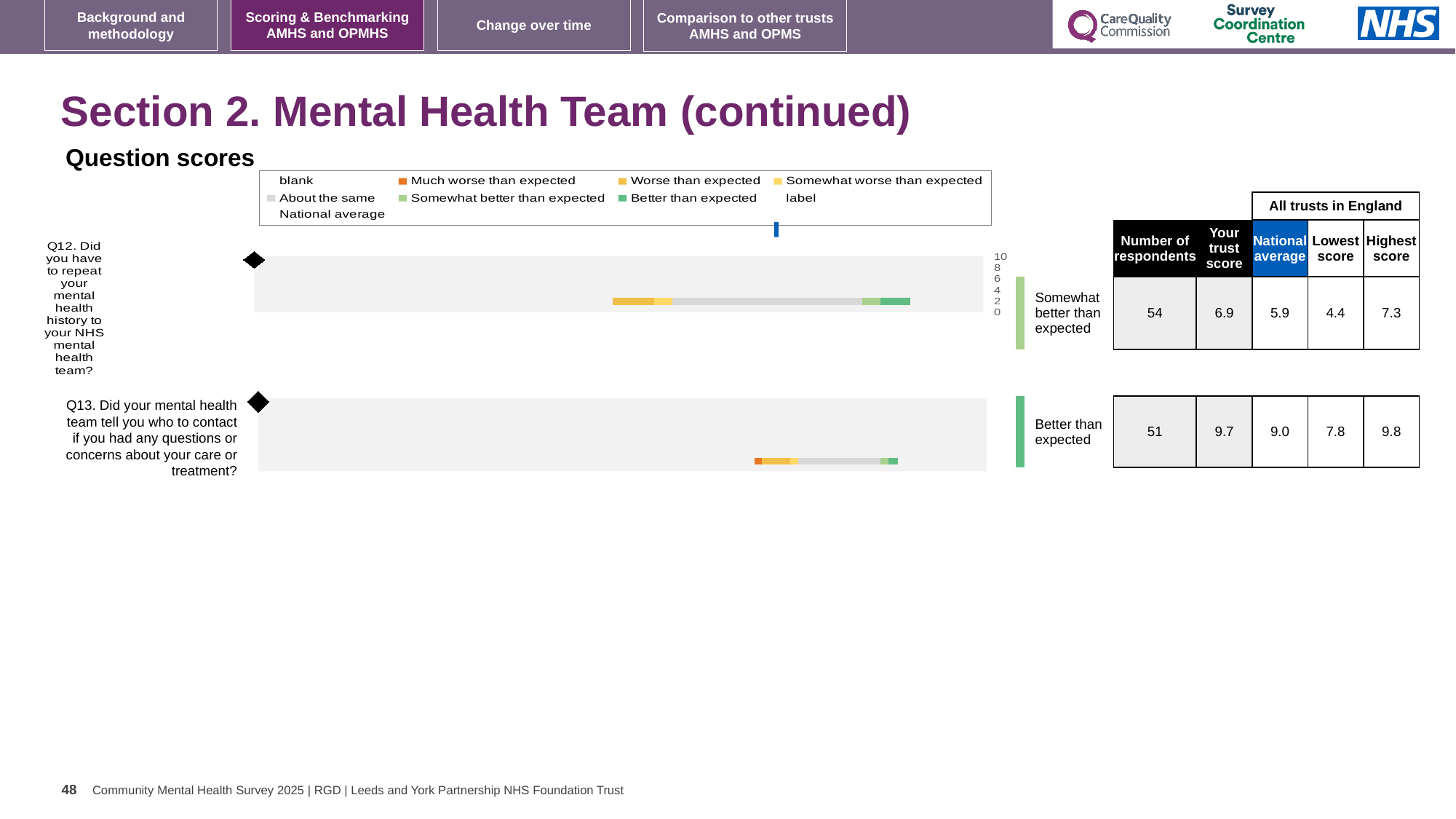
How many questions are shown on the slide's question score charts? 2 How many respondents answered Q13? 51 What is the trust score for Q13 (told who to contact with questions or concerns)? 9.7 What kind of chart is used to show the question scores for Q12 and Q13? bar chart What is the national average score for Q12? 5.9 Which question has the higher trust score, Q12 or Q13? Q13 For Q13, which is larger: the trust score or the national average? the trust score What benchmark category is shown next to the Q12 chart? Somewhat better than expected What is the difference between the trust score and the national average for Q12? 1.0 Is the trust score for Q12 greater or less than 6 on the chart's axis? greater What is the highest score among all trusts in England for Q13? 9.8 What is the trust score for Q12 (repeating mental health history)? 6.9